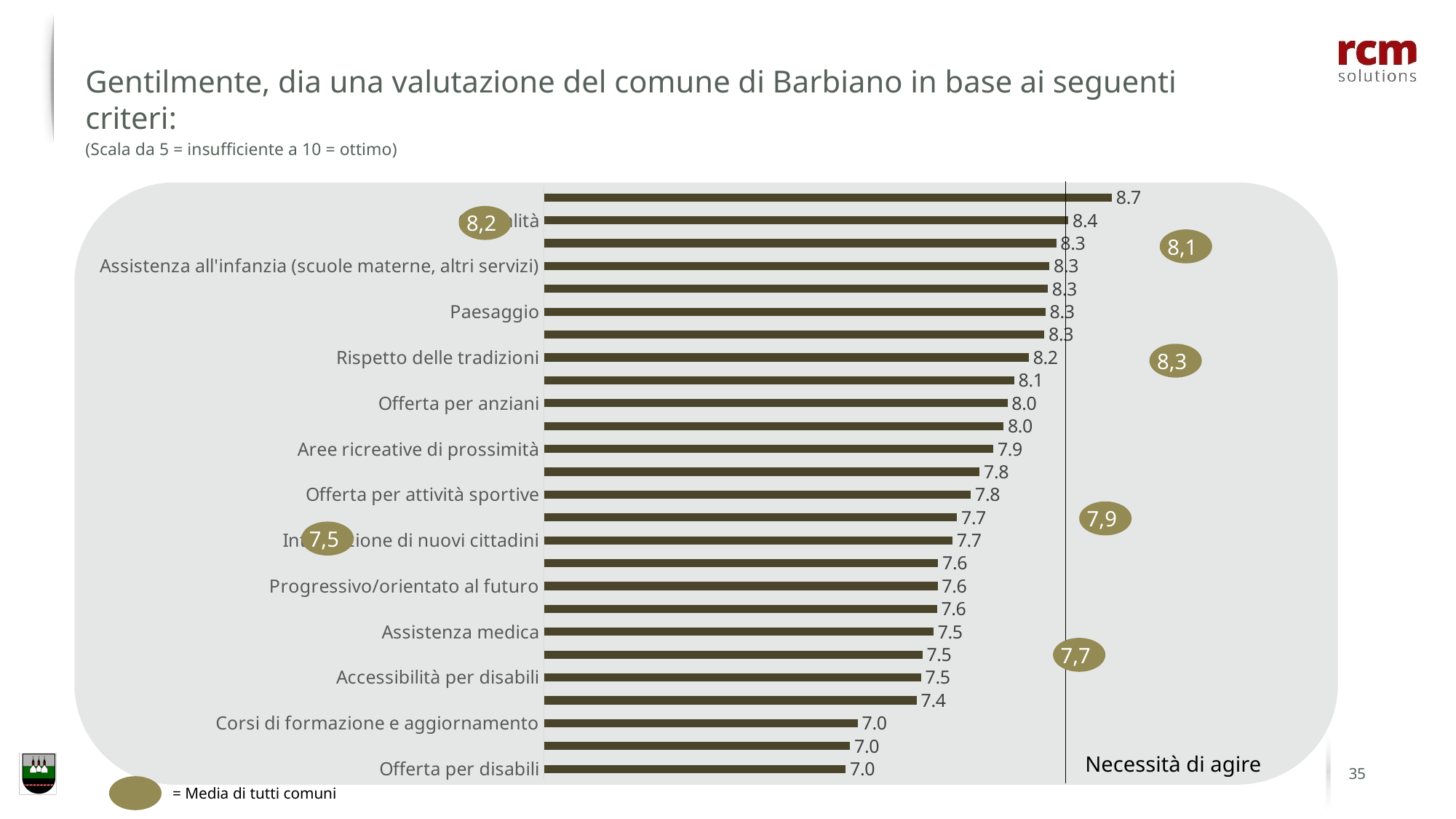
What is the value for Aree ricreative di prossimità? 7.9 What is the difference between the values for Rispetto delle tradizioni and Offerta per disabili? 1.2 What is the highest value shown on the chart? 8.7 What is the label of the vertical line drawn across the chart? Necessità di agire Which has a higher value, Offerta per anziani or Corsi di formazione e aggiornamento? Offerta per anziani What is the value for Corsi di formazione e aggiornamento? 7.0 What is the value for Rispetto delle tradizioni? 8.2 What is the value for Paesaggio? 8.3 What is the value for Assistenza all'infanzia (scuole materne, altri servizi)? 8.3 What type of chart is shown on the slide? bar chart How many bars are plotted on the chart? 26 What is the value for Offerta per anziani? 8.0